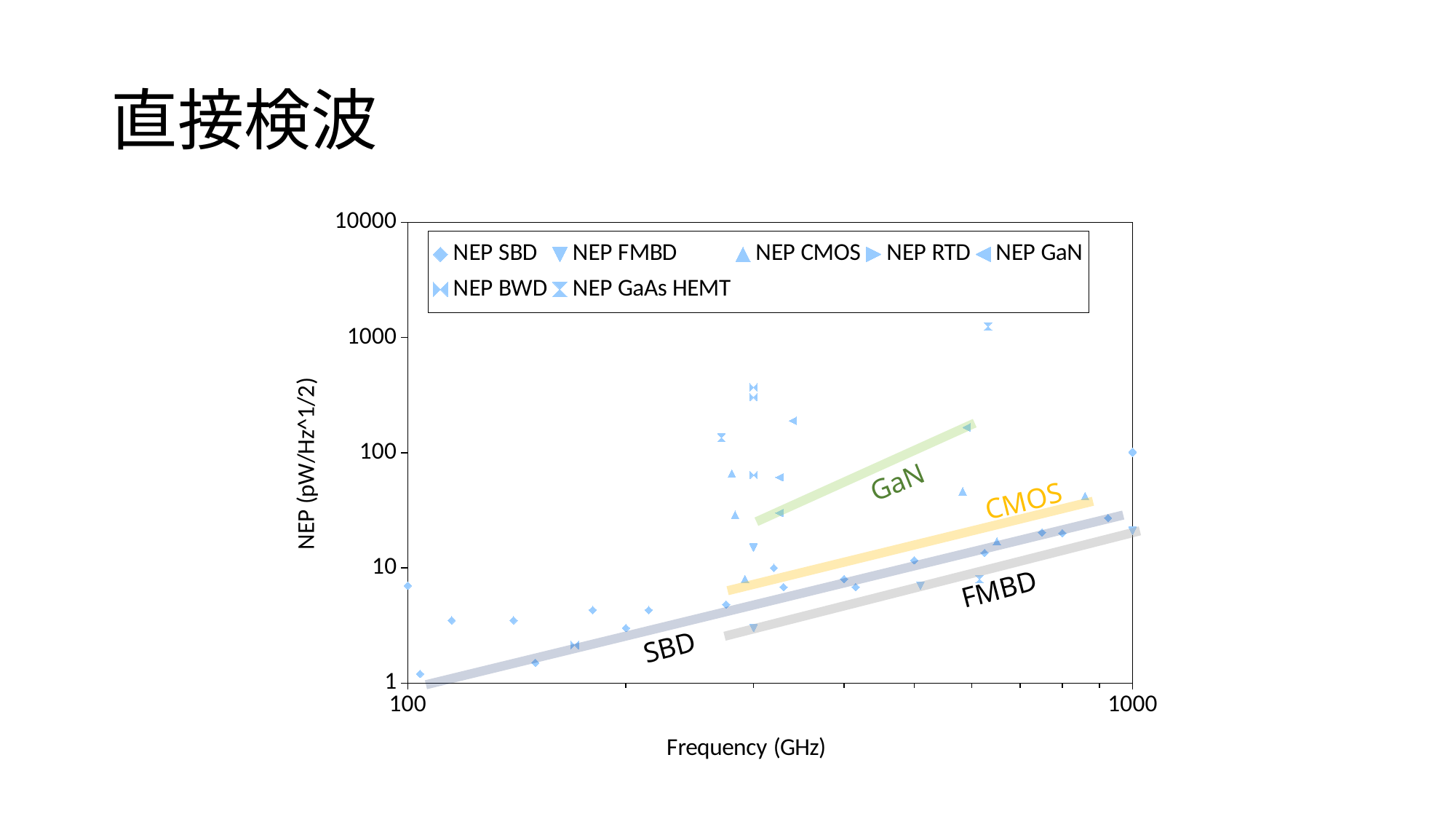
Is the value of the NEP GaAs HEMT point near 1000 GHz greater or less than 1000? greater What kind of chart is shown on the slide? scatter chart Do the NEP SBD values generally rise or fall as frequency increases from 100 GHz to 1000 GHz? rise Which series has the highest plotted value on the chart? NEP GaAs HEMT What is the label of the x axis? Frequency (GHz) Is the value of the NEP CMOS point near 600 GHz greater or less than 100? less Is the value of the NEP SBD point at 100 GHz greater or less than 10? less What is the label of the y axis? NEP (pW/Hz^1/2) Which of the two points near 300 GHz is larger, the NEP BWD point or the NEP FMBD point? NEP BWD How many series does the legend list? 7